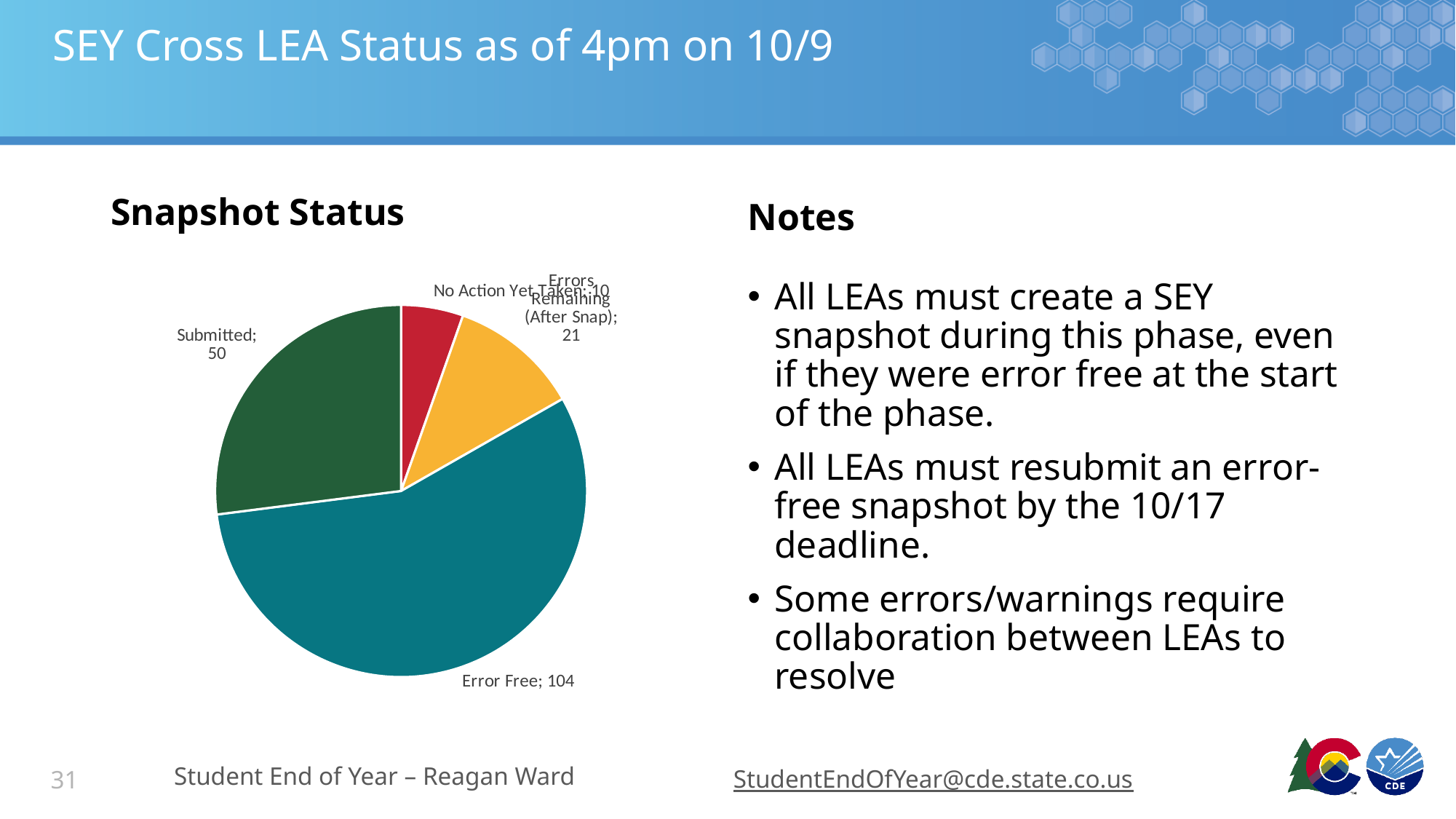
What is the value for Error Free? 104 How many slices does the pie chart have? 4 What is the total of all slices in the pie chart? 185 What is the value for No Action Yet Taken? 10 What is the value for Submitted? 50 Which category has the smallest slice? No Action Yet Taken Which category has the largest slice? Error Free What type of chart is shown on the slide? Pie chart What is the title of the chart? Snapshot Status What is the difference between the Error Free and Submitted values? 54 Which is larger, Errors Remaining (After Snap) or No Action Yet Taken? Errors Remaining (After Snap) What is the value for Errors Remaining (After Snap)? 21